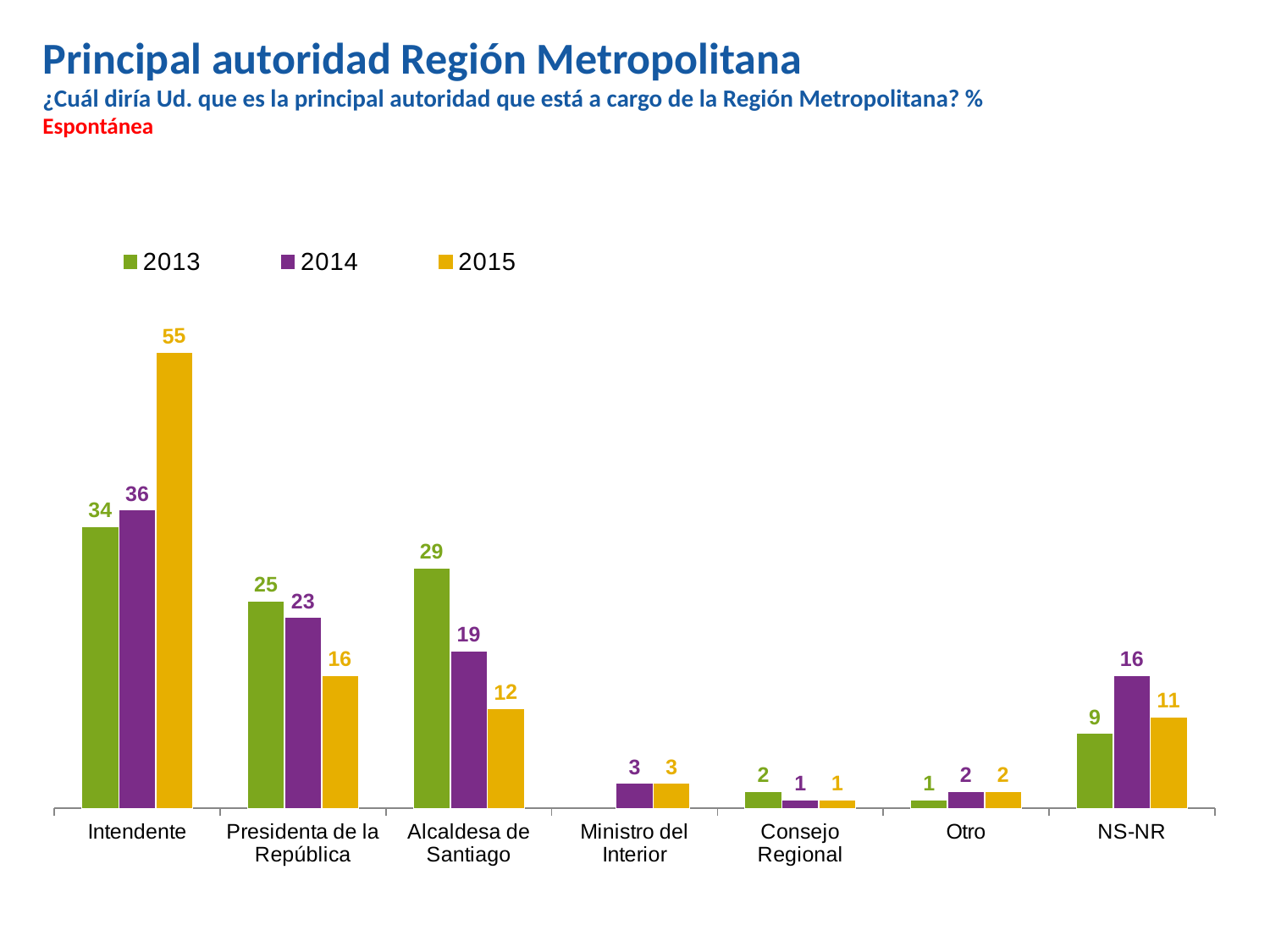
How many series does the legend list? 3 How many categories are shown on the x axis? 7 Do the values for Alcaldesa de Santiago rise or fall from 2013 to 2015? Fall What is the 2014 value for Alcaldesa de Santiago? 19 Which category has the highest value in the 2015 series? Intendente What is the 2013 value for NS-NR? 9 What is the difference between the 2013 and 2015 values for Alcaldesa de Santiago? 17 What kind of chart is shown on the slide? Bar chart What is the difference between the 2015 and 2013 values for Intendente? 21 Which is larger for Presidenta de la República: the 2013 value or the 2015 value? 2013 What is the 2015 value for Intendente? 55